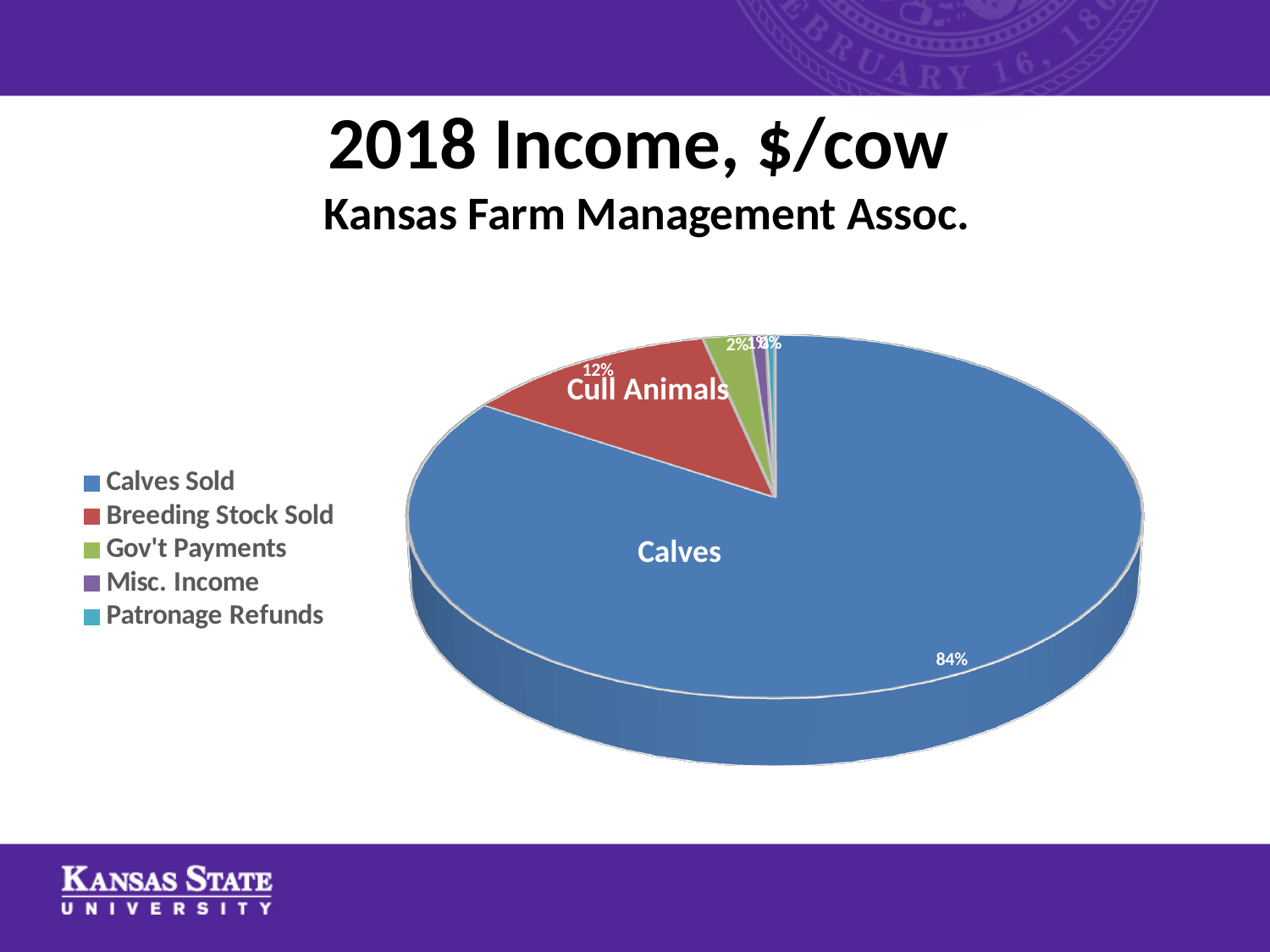
What share of 2018 income per cow comes from Calves Sold? 84% What is the title of the chart on the slide? 2018 Income, $/cow What text label is written on the red slice of the pie chart? Cull Animals Which is larger, the share for Breeding Stock Sold or the share for Gov't Payments? Breeding Stock Sold Is the share for Calves Sold greater or less than 50%? greater How many categories does the legend of the pie chart list? 5 By how many percentage points does the Calves Sold share exceed the Breeding Stock Sold share? 72 percentage points What share of 2018 income per cow comes from Breeding Stock Sold? 12% What kind of chart is shown on the slide? pie chart What share of 2018 income per cow comes from Gov't Payments? 2% Which category accounts for the largest share of 2018 income per cow? Calves Sold